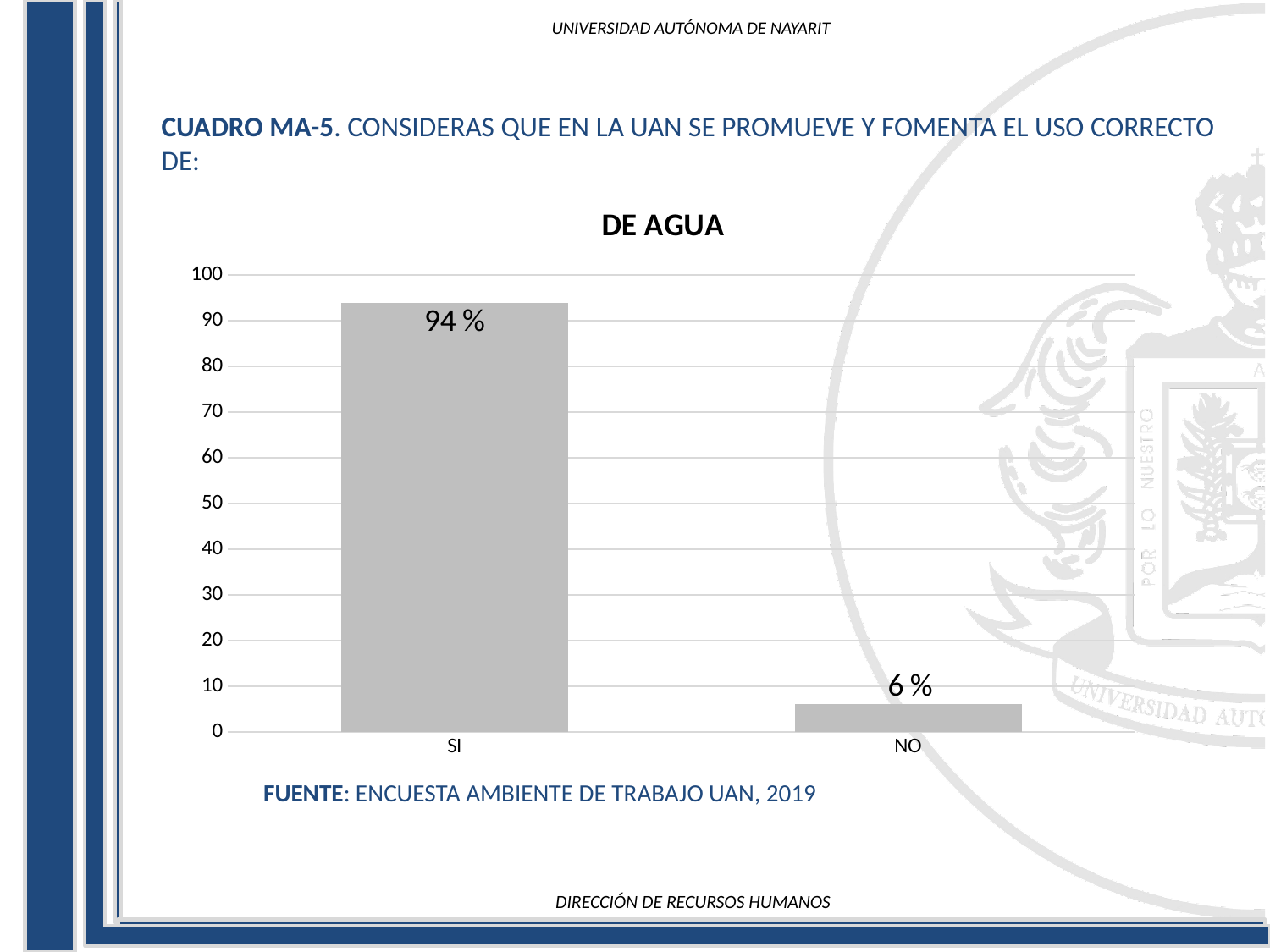
What is the title of the chart? DE AGUA Is the value for SI greater or less than 90? greater What is the highest value shown on the y axis? 100 What kind of chart is shown? bar chart What is the value for NO? 6 % What is the difference between the values for SI and NO? 88 % Is the value for NO greater or less than 10? less Which category has the lowest value? NO How many categories are shown on the x axis? 2 What is the value for SI? 94 % Which category has the highest value? SI Which is larger, the value for SI or the value for NO? SI